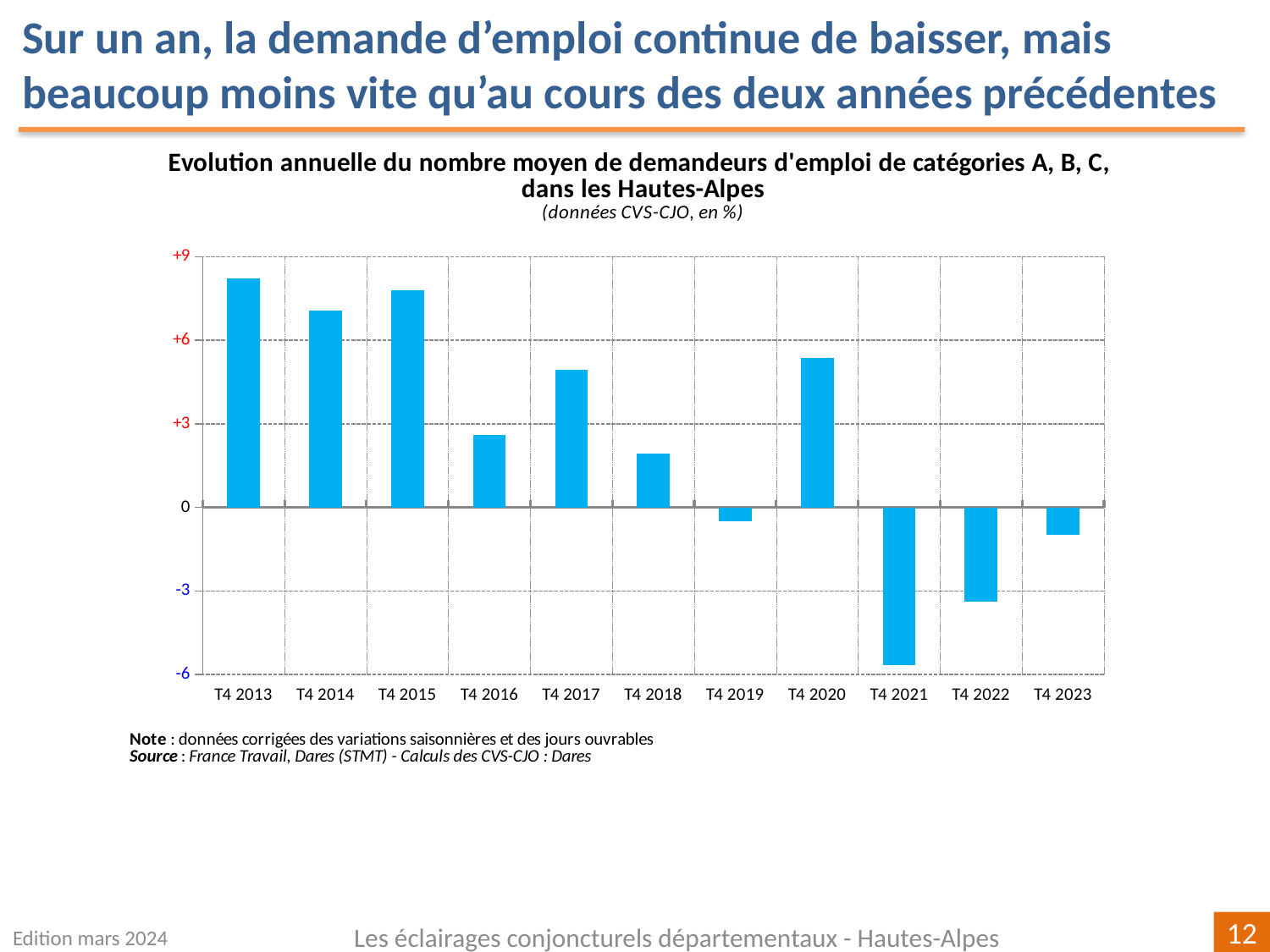
Is the value for T4 2020 greater or less than +3? greater Is the value for T4 2021 greater or less than -3? less What kind of chart is shown on the slide? bar chart Overall, do the values rise or fall from T4 2013 to T4 2023? fall Is the value for T4 2013 greater or less than +6? greater Which quarter has the highest value? T4 2013 Which is larger, the value for T4 2014 or the value for T4 2016? T4 2014 Which is larger, the value for T4 2021 or the value for T4 2022? T4 2022 How many quarters (categories) are plotted on the x axis? 11 In what unit are the chart's data expressed, according to the subtitle? en % Which quarter has the lowest value? T4 2021